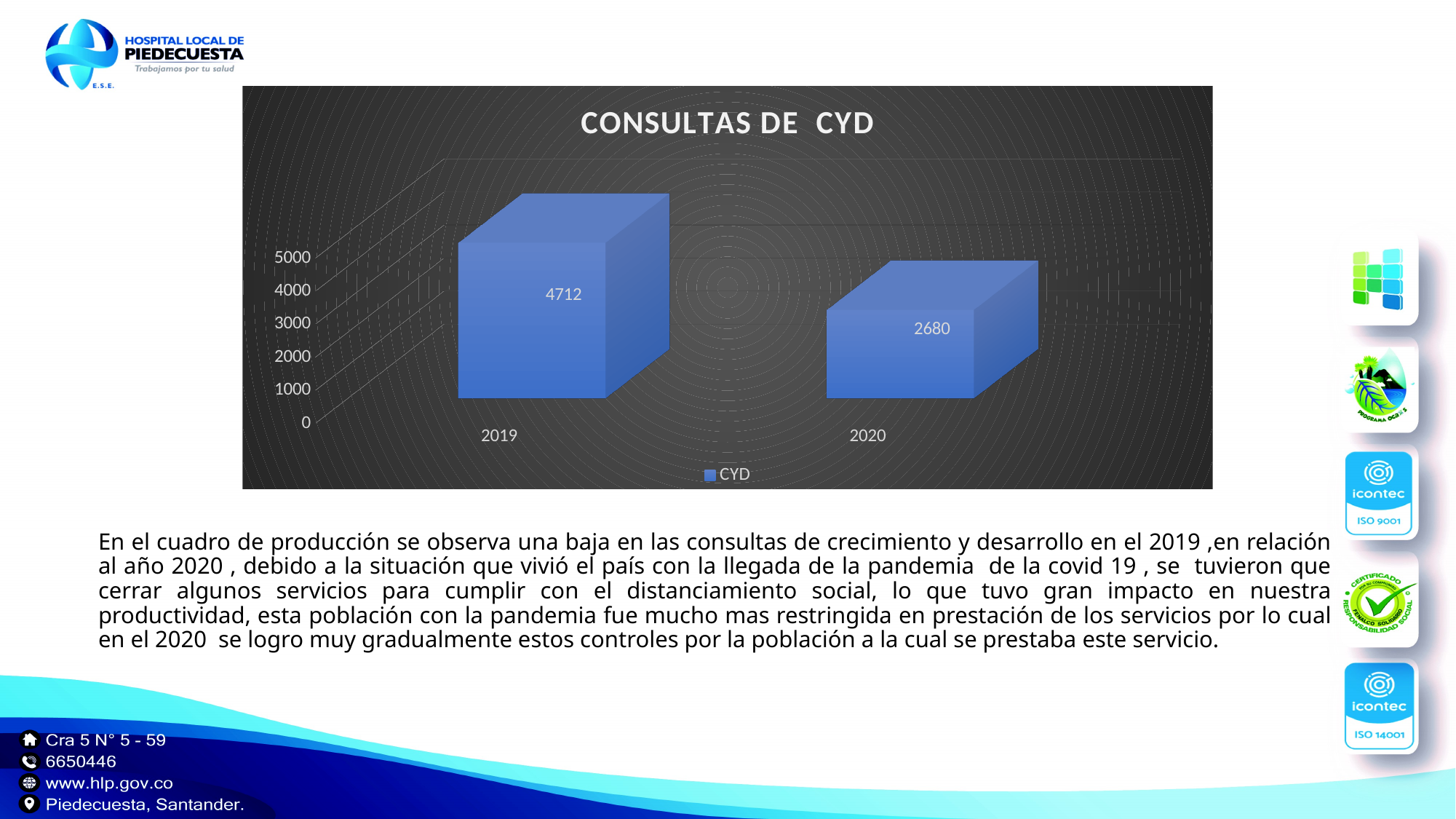
What kind of chart is shown on the slide? Bar chart What is the difference between the 2019 and 2020 values in the CONSULTAS DE CYD chart? 2032 How many categories are shown on the x axis of the CONSULTAS DE CYD chart? 2 Is the value for 2019 in the CONSULTAS DE CYD chart greater or less than 4000? greater How many series does the legend of the CONSULTAS DE CYD chart list? 1 What is the value for 2019 in the CONSULTAS DE CYD chart? 4712 Which year has the lowest value in the CONSULTAS DE CYD chart? 2020 Is the value for 2020 in the CONSULTAS DE CYD chart greater or less than 3000? less Do the values in the CONSULTAS DE CYD chart rise or fall from 2019 to 2020? Fall What is the value for 2020 in the CONSULTAS DE CYD chart? 2680 Which is larger in the CONSULTAS DE CYD chart, the value for 2019 or the value for 2020? 2019 Which year has the highest value in the CONSULTAS DE CYD chart? 2019